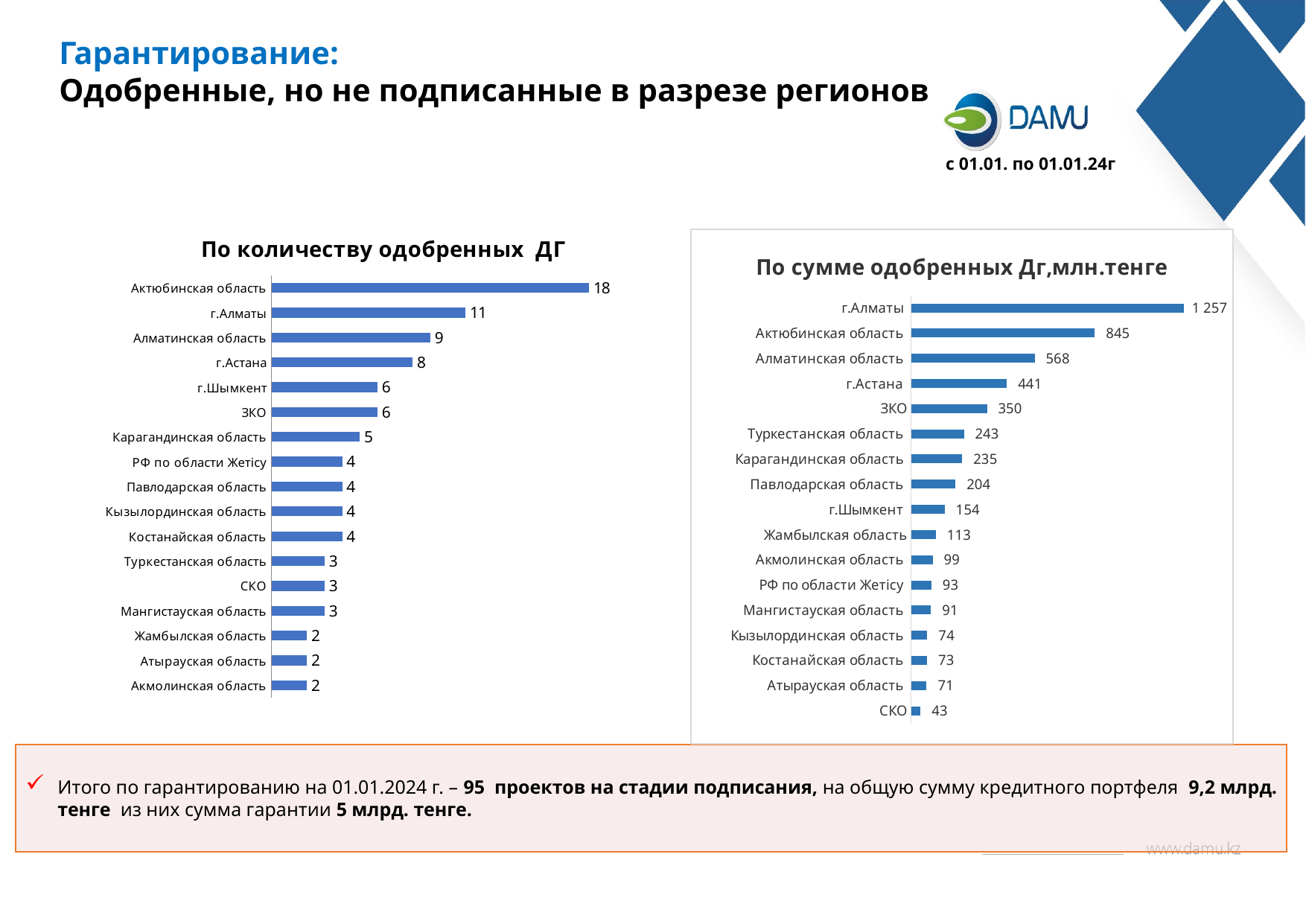
In the chart 'По количеству одобренных ДГ', which region has the highest value? Актюбинская область In the chart 'По сумме одобренных Дг,млн.тенге', what is the difference between Актюбинская область and Алматинская область? 277 In the chart 'По сумме одобренных Дг,млн.тенге', which is larger: Туркестанская область or Карагандинская область? Туркестанская область In the chart 'По количеству одобренных ДГ', what is the value for г.Астана? 8 What type of chart is 'По сумме одобренных Дг,млн.тенге'? bar chart In the chart 'По количеству одобренных ДГ', what is the value for Карагандинская область? 5 In the chart 'По количеству одобренных ДГ', how many regions are shown? 17 What is the title of the chart on the left side of the slide? По количеству одобренных ДГ In the chart 'По сумме одобренных Дг,млн.тенге', what is the value for г.Алматы? 1 257 In the chart 'По количеству одобренных ДГ', what is the difference between Актюбинская область and г.Алматы? 7 In the chart 'По сумме одобренных Дг,млн.тенге', what is the value for г.Шымкент? 154 In the chart 'По сумме одобренных Дг,млн.тенге', which region has the lowest value? СКО